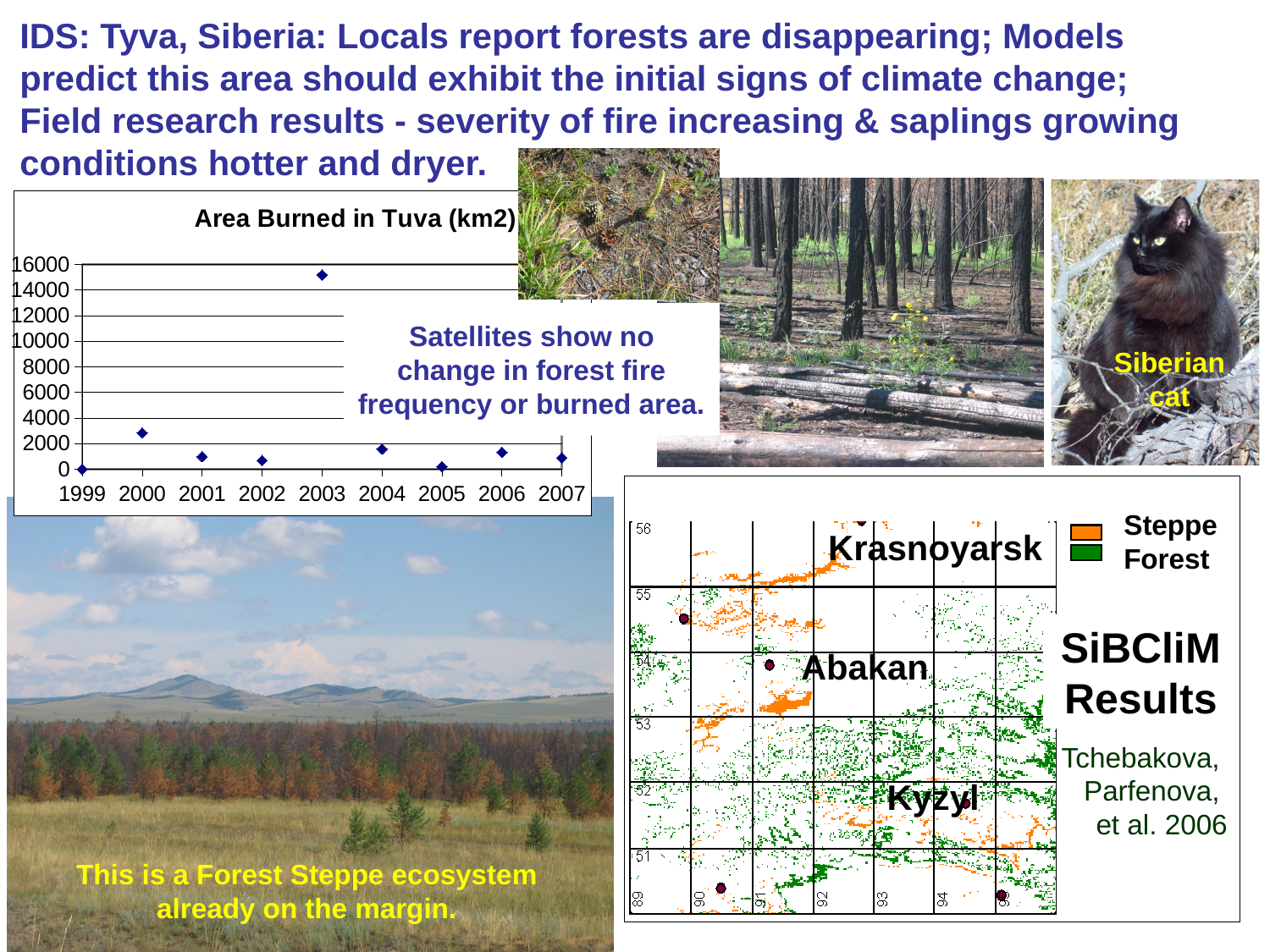
In the 'Area Burned in Tuva (km2)' chart, is the value for 2003 greater or less than 14000? greater In the 'Area Burned in Tuva (km2)' chart, is the value for 2004 greater or less than 4000? less What kind of chart is 'Area Burned in Tuva (km2)'? scatter chart In the 'Area Burned in Tuva (km2)' chart, is the value for 2000 greater or less than 2000? greater What is the title of the chart on the slide? Area Burned in Tuva (km2) How many years are plotted in the 'Area Burned in Tuva (km2)' chart? 9 In the 'Area Burned in Tuva (km2)' chart, which year has the larger area burned, 2000 or 2001? 2000 What is the first year shown on the x axis of the 'Area Burned in Tuva (km2)' chart? 1999 In the 'Area Burned in Tuva (km2)' chart, which year has the larger area burned, 2003 or 2004? 2003 In the 'Area Burned in Tuva (km2)' chart, which year has the highest area burned? 2003